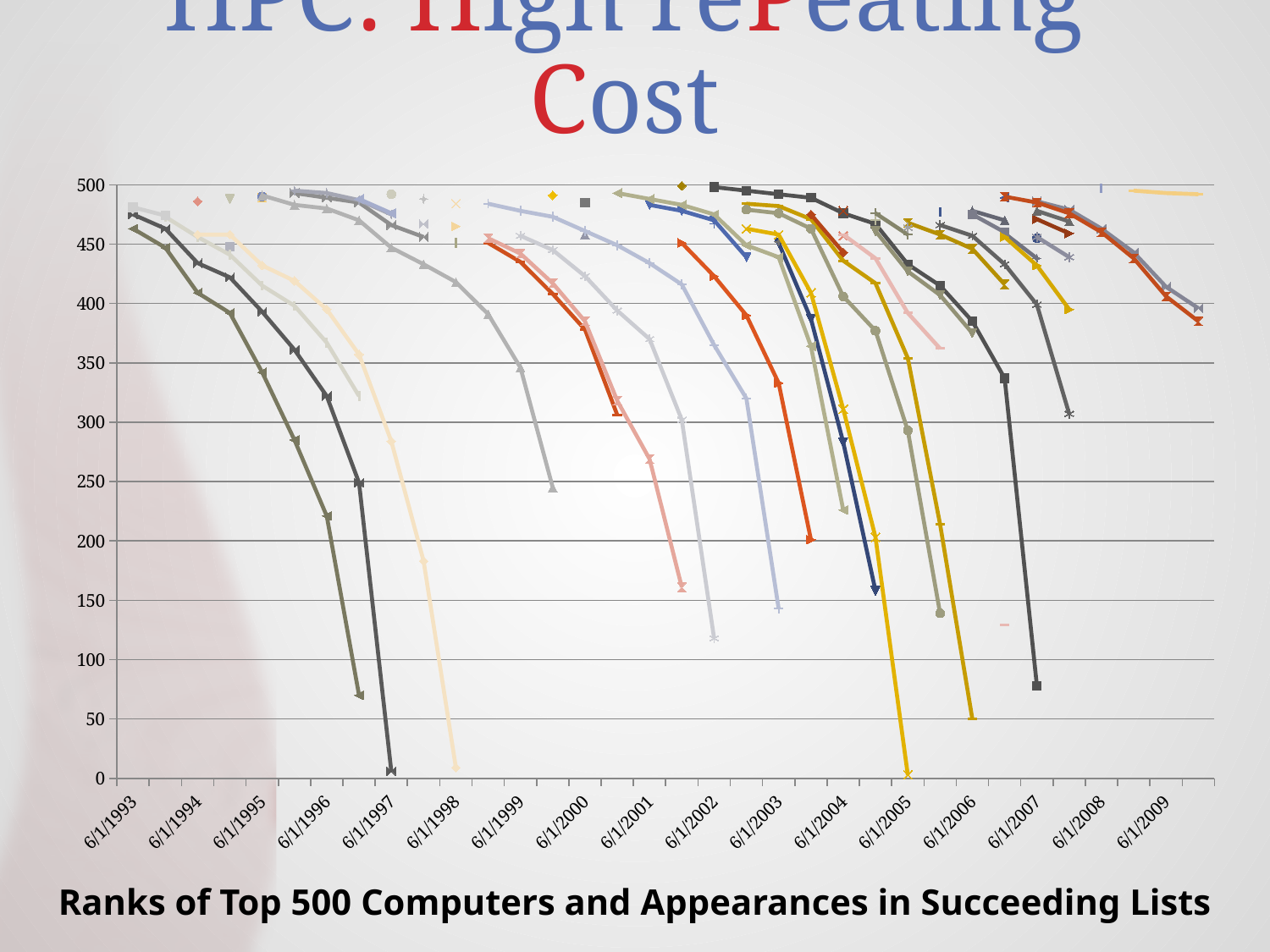
What is the caption printed below the chart? Ranks of Top 500 Computers and Appearances in Succeeding Lists How many date labels are printed along the horizontal axis of the chart? 17 What is the first date label on the horizontal axis of the chart? 6/1/1993 What kind of chart is shown on the slide? line chart What is the last date label on the horizontal axis of the chart? 6/1/2009 Do the plotted lines generally rise or fall as they move to the right along the x axis? fall What is the highest value labelled on the vertical axis of the chart? 500 What is the interval between consecutive tick labels on the vertical axis? 50